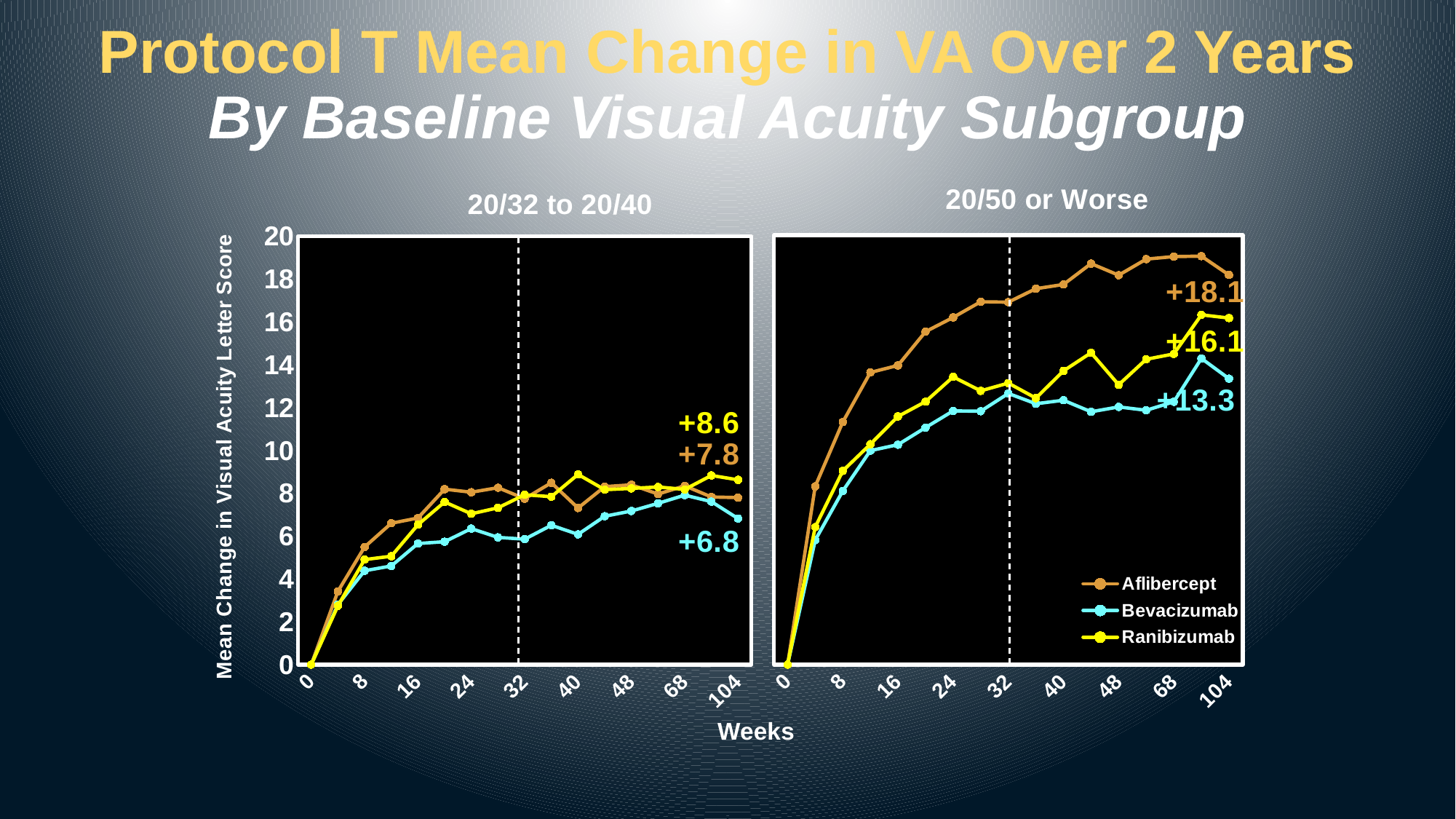
In the '20/50 or Worse' chart, which treatment has the highest labelled value at week 104? Aflibercept In the '20/50 or Worse' chart, what is the labelled mean change in visual acuity letter score for Aflibercept at week 104? +18.1 In the '20/50 or Worse' chart, does the Aflibercept line generally rise or fall from week 0 to week 32? Rise How many series does the legend list? 3 In the '20/32 to 20/40' chart, what is the labelled mean change for Ranibizumab at week 104? +8.6 In the '20/50 or Worse' chart, what is the difference between the labelled week-104 values for Aflibercept and Bevacizumab? 4.8 In the '20/32 to 20/40' chart, what is the labelled mean change for Bevacizumab at week 104? +6.8 In the '20/50 or Worse' chart, is the value for Aflibercept at week 104 greater or less than 16? greater What kind of chart is used on this slide? Line chart In the '20/50 or Worse' chart, what is the labelled mean change for Bevacizumab at week 104? +13.3 In the '20/32 to 20/40' chart, which is larger at week 104: the labelled value for Ranibizumab or for Aflibercept? Ranibizumab In the '20/32 to 20/40' chart, which treatment has the lowest labelled value at week 104? Bevacizumab